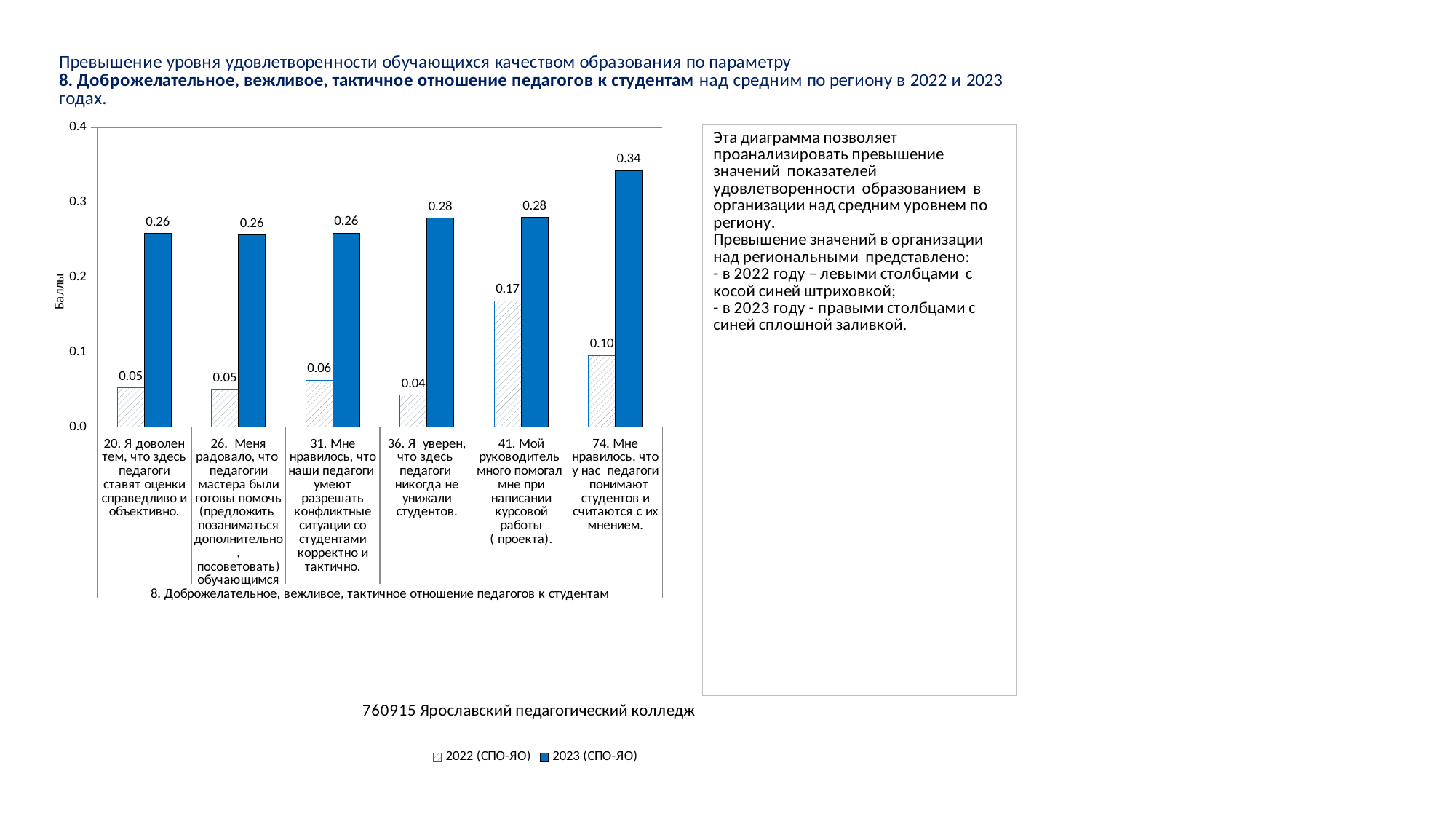
For category 41, which series has the larger value, 2022 (СПО-ЯО) or 2023 (СПО-ЯО)? 2023 (СПО-ЯО) What is the 2022 (СПО-ЯО) value for category 41 (Мой руководитель много помогал мне при написании курсовой работы)? 0.17 What is the difference between the 2023 and 2022 values for category 74? 0.24 How many series does the legend list? 2 How many categories (questions) are shown on the x axis? 6 Which category has the lowest 2022 (СПО-ЯО) value? 36. Я уверен, что здесь педагоги никогда не унижали студентов. What is the 2023 (СПО-ЯО) value for category 74 (Мне нравилось, что у нас педагоги понимают студентов и считаются с их мнением)? 0.34 Which category has the highest 2023 (СПО-ЯО) value? 74. Мне нравилось, что у нас педагоги понимают студентов и считаются с их мнением. Is the 2023 (СПО-ЯО) value for category 20 greater or less than 0.3? less What is the 2022 (СПО-ЯО) value for category 36 (Я уверен, что здесь педагоги никогда не унижали студентов)? 0.04 What is the label of the vertical axis? Баллы What type of chart is shown on the slide? bar chart